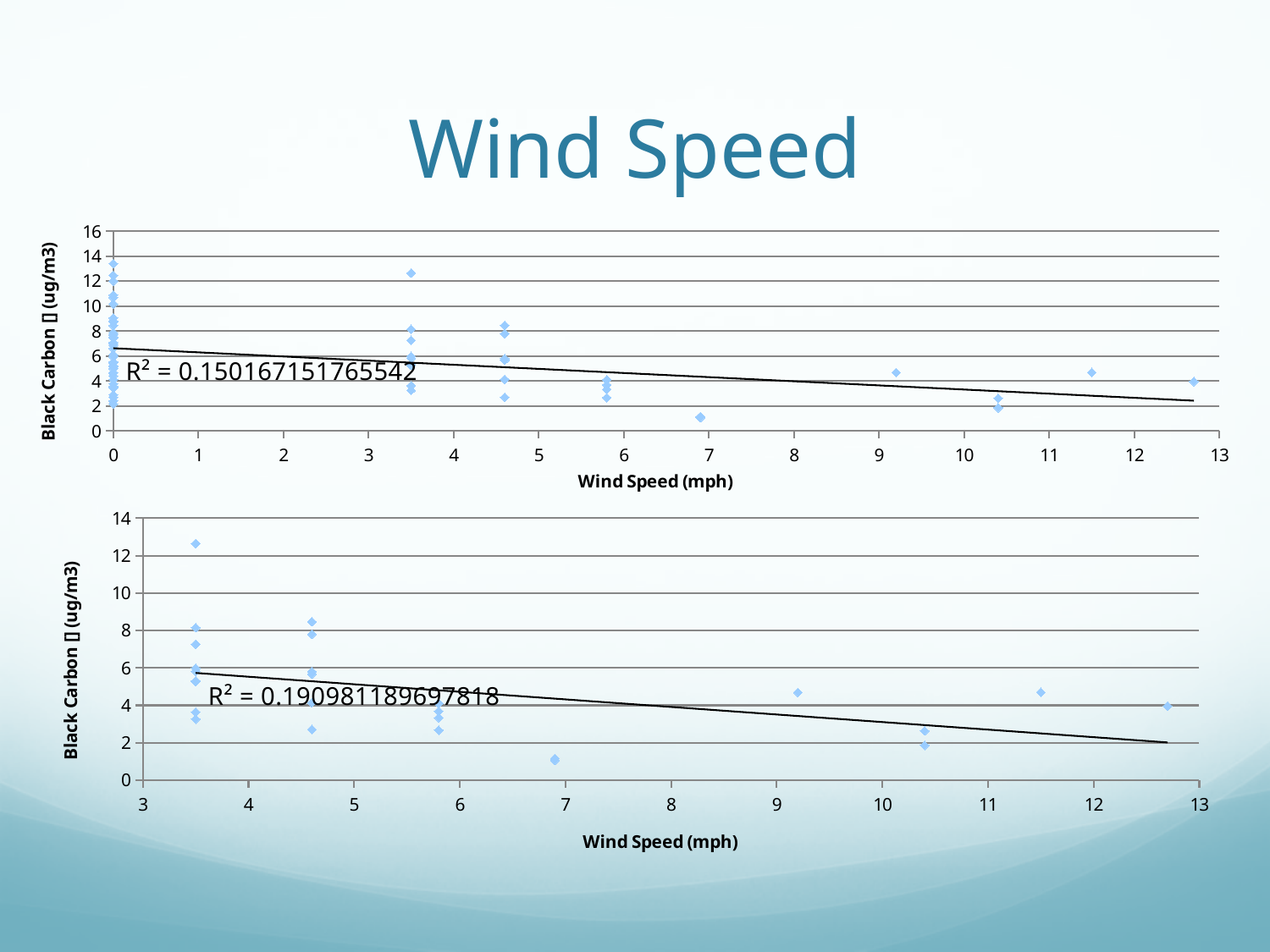
In the top chart, what R² value is printed for the trend line? R² = 0.150167151765542 In the bottom chart, is the highest black carbon value plotted greater or less than 12? greater In the bottom chart, does the trend line rise or fall as wind speed increases? fall What is the x-axis label of the top chart? Wind Speed (mph) In the bottom chart, what R² value is printed for the trend line? R² = 0.190981189697818 In the top chart, is the black carbon value for the point at about 7 mph wind speed greater or less than 2? less In the bottom chart, is the black carbon value for the point at about 7 mph wind speed greater or less than 2? less What is the title of the slide? Wind Speed How many charts are shown on the slide? 2 What kind of chart is the top chart on the slide? scatter chart What kind of chart is the bottom chart on the slide? scatter chart In the top chart, does the trend line rise or fall as wind speed increases? fall